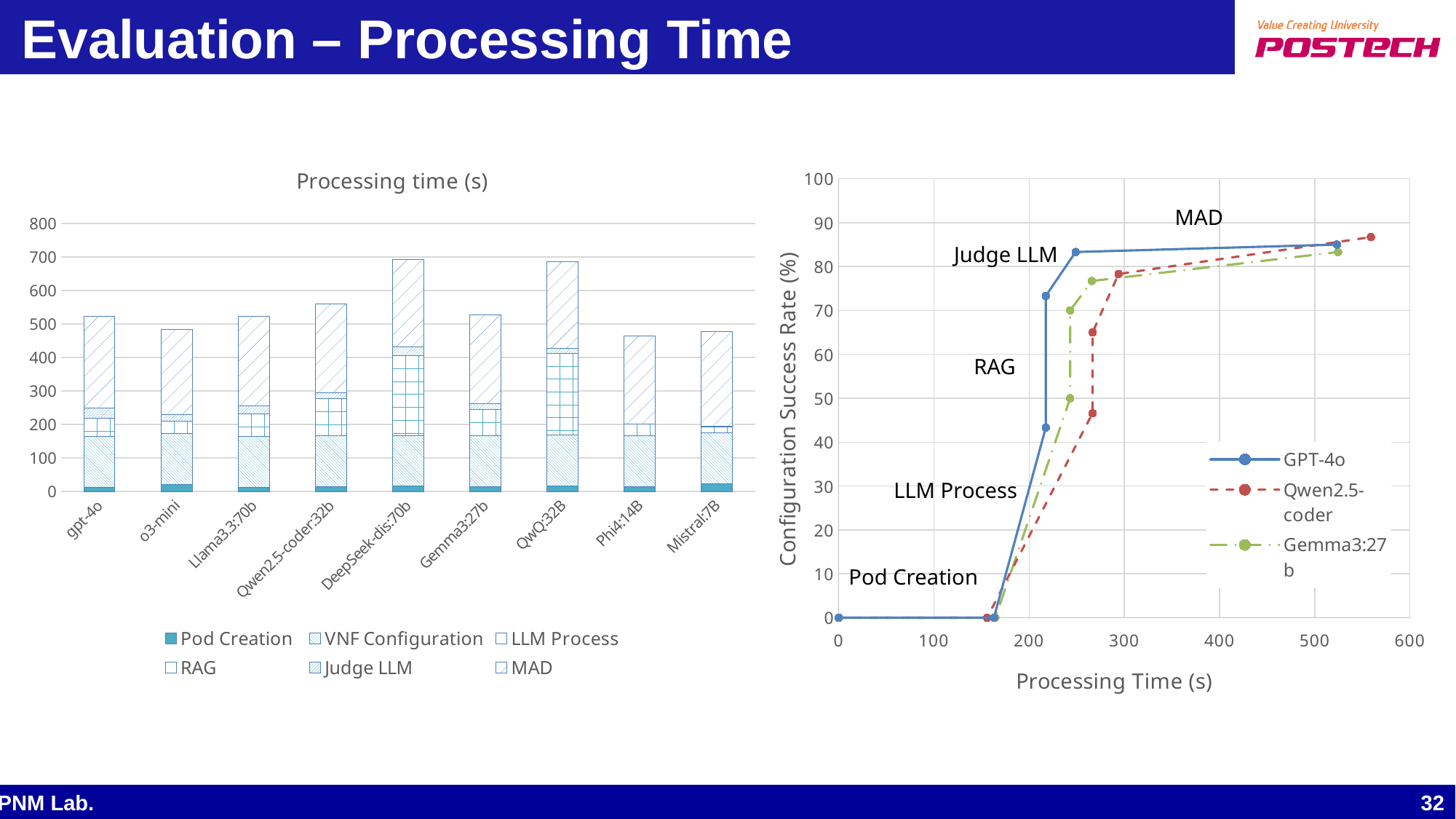
In the left chart 'Processing time (s)', is the total processing time for DeepSeek-dis:70b greater or less than 600? greater In the right chart, is the final configuration success rate for GPT-4o greater or less than 80? greater What kind of chart is the right chart with the x axis 'Processing Time (s)'? line chart In the left chart 'Processing time (s)', which has the larger total processing time, DeepSeek-dis:70b or Phi4:14B? DeepSeek-dis:70b In the right chart, how many series does the legend list? 3 In the right chart, does the configuration success rate rise or fall as processing time increases? rise In the left chart 'Processing time (s)', is the total processing time for Qwen2.5-coder:32b greater or less than 500? greater In the left chart 'Processing time (s)', how many series does the legend list? 6 What kind of chart is the left chart titled 'Processing time (s)'? stacked bar chart In the right chart, what is the label of the y axis? Configuration Success Rate (%) In the left chart 'Processing time (s)', how many models are shown on the x axis? 9